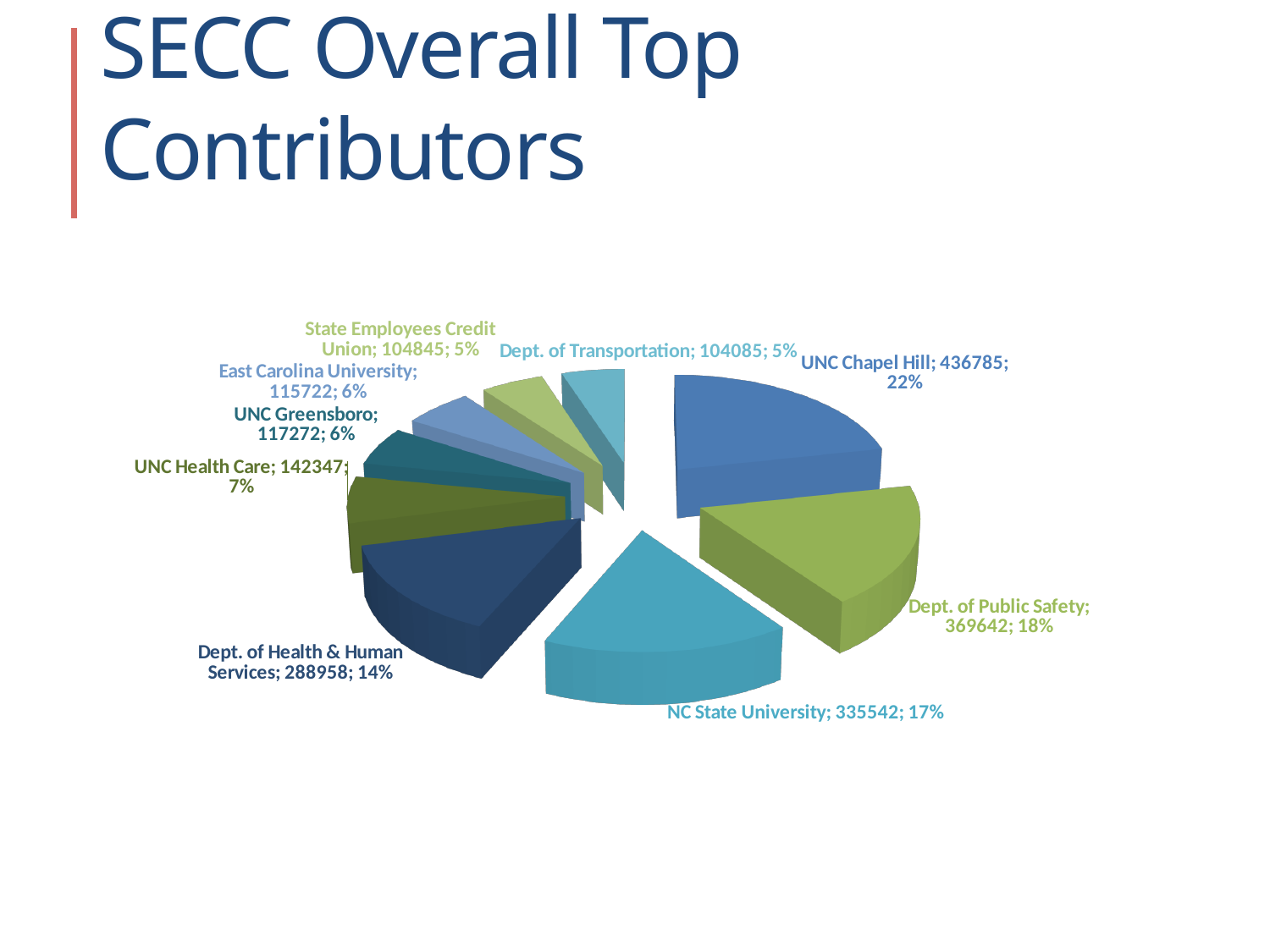
How many contributors (slices) are shown in the pie chart? 9 What share of the pie does Dept. of Public Safety represent? 18% What kind of chart is shown on the slide? Pie chart What is the value shown for UNC Chapel Hill? 436785 What is the difference between the values for UNC Chapel Hill and Dept. of Public Safety? 67143 What is the value shown for UNC Health Care? 142347 Which contributor has the smallest value in the pie chart? Dept. of Transportation What is the title of the slide containing the pie chart? SECC Overall Top Contributors Which contributor has the largest slice of the pie? UNC Chapel Hill Which has the larger value, UNC Greensboro or East Carolina University? UNC Greensboro What is the value shown for Dept. of Health & Human Services? 288958 What share of the pie does NC State University represent? 17%